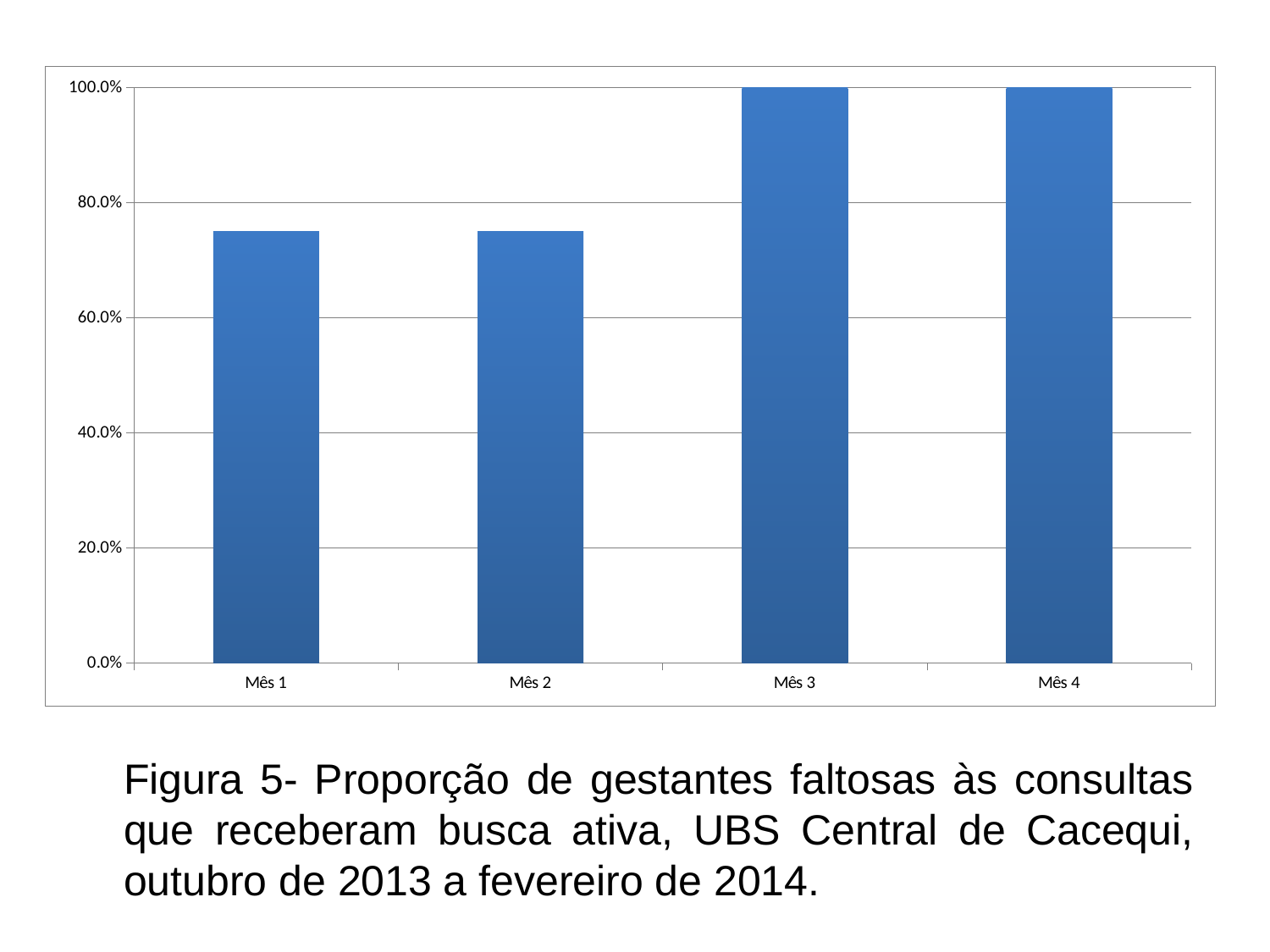
Do the values rise or fall from Mês 1 to Mês 4? rise What figure number is given in the caption below the chart? Figura 5 What kind of chart is shown on the slide? bar chart Is the value for Mês 2 greater or less than 60.0%? greater Is the value for Mês 1 greater or less than 80.0%? less Which is larger, the value for Mês 1 or the value for Mês 3? Mês 3 Is the value for Mês 1 greater or less than 60.0%? greater What is the value for Mês 3? 100.0% Which is larger, the value for Mês 2 or the value for Mês 4? Mês 4 How many categories (months) are shown on the x axis of the chart? 4 What is the value for Mês 4? 100.0%